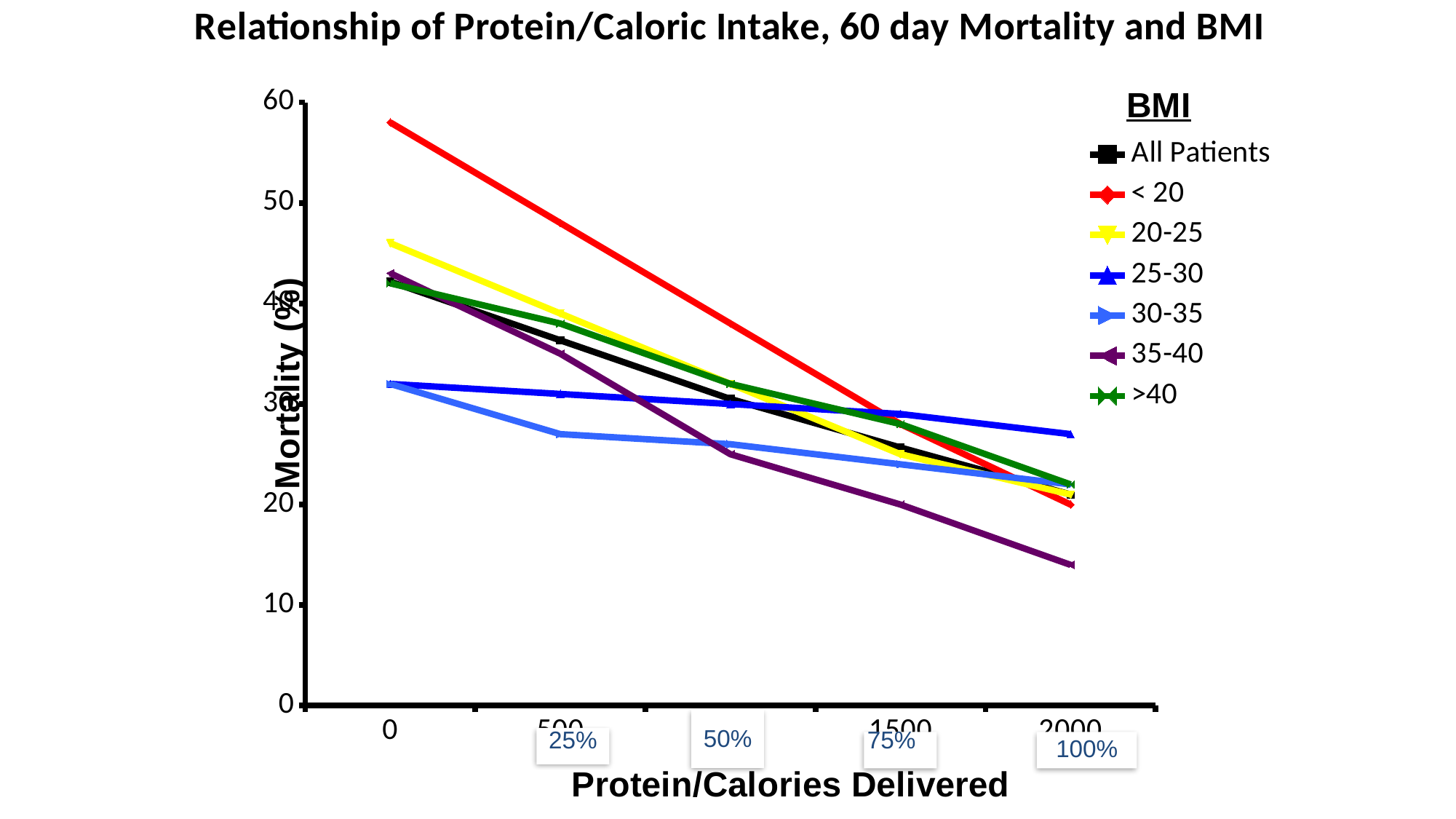
What is the label of the x axis? Protein/Calories Delivered At 0 protein/calories delivered, which has higher mortality: the < 20 series or the 25-30 series? < 20 How many series does the legend list? 7 What kind of chart is shown on the slide? line chart At 2000 protein/calories delivered, which has higher mortality: the 25-30 series or the 35-40 series? 25-30 Is the mortality for the 25-30 BMI series at 0 protein/calories delivered greater or less than 40? less Which BMI series has the highest mortality at 0 protein/calories delivered? < 20 What is the title of the chart? Relationship of Protein/Caloric Intake, 60 day Mortality and BMI Which BMI series has the lowest mortality at 2000 protein/calories delivered? 35-40 Is the mortality for the < 20 BMI series at 0 protein/calories delivered greater or less than 50? greater Is the mortality for the 35-40 BMI series at 2000 protein/calories delivered greater or less than 20? less Does mortality for the All Patients series rise or fall as protein/calories delivered increases? fall